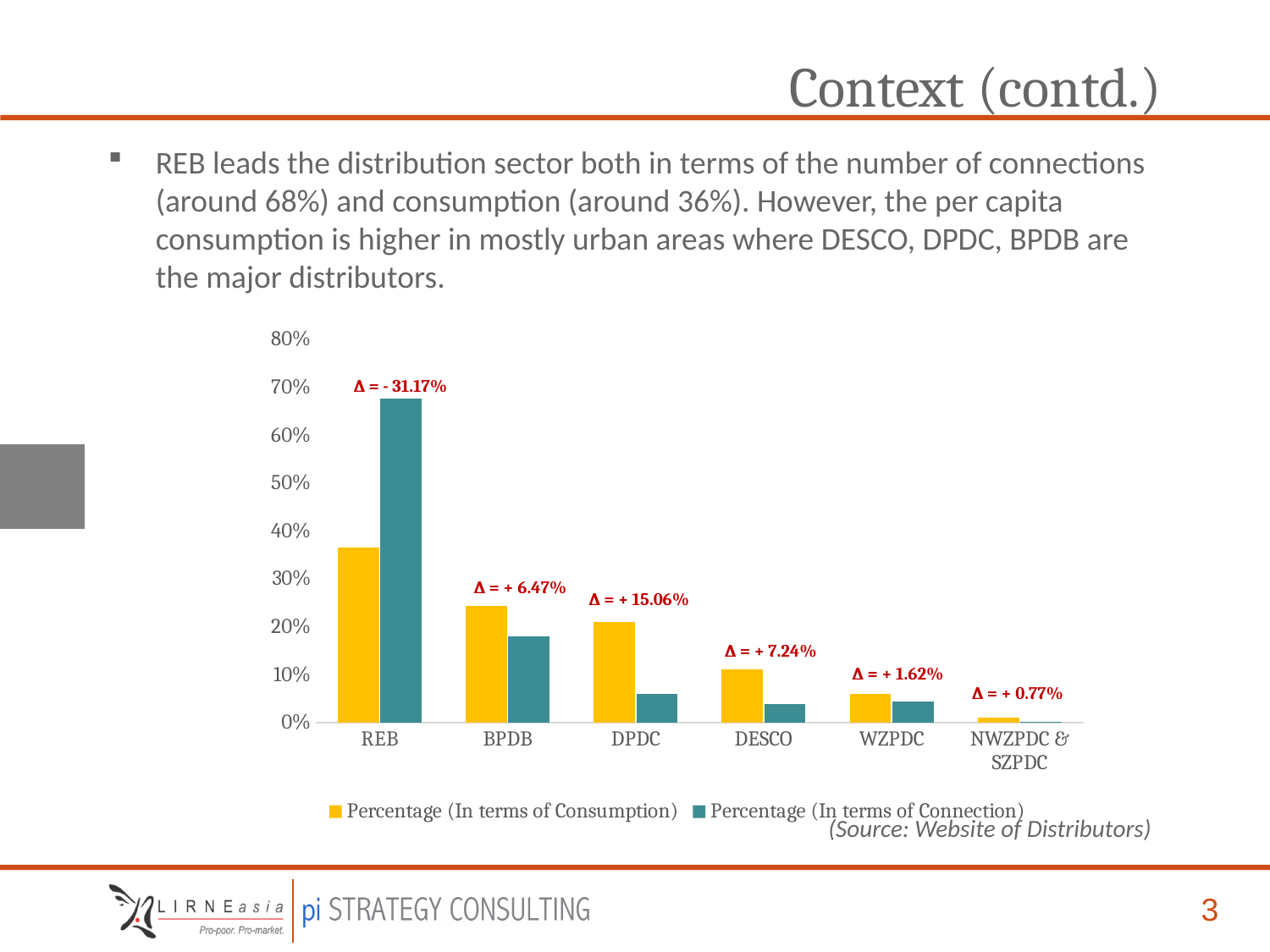
What is the Δ value annotated above the WZPDC bars? Δ = + 1.62% What kind of chart is shown on the slide? bar chart How many series does the chart legend list? 2 Is the value for REB in terms of Consumption greater or less than 40%? less Is the value for REB in terms of Connection greater or less than 60%? greater Which distributor has the highest value for Percentage (In terms of Connection)? REB What is the Δ value annotated above the DPDC bars? Δ = + 15.06% For BPDB, which is larger: Percentage (In terms of Consumption) or Percentage (In terms of Connection)? Percentage (In terms of Consumption) What is the Δ value annotated above the REB bars? Δ = - 31.17% Do the Percentage (In terms of Consumption) values rise or fall moving from REB to NWZPDC & SZPDC along the x axis? fall Which distributor has the lowest value for Percentage (In terms of Consumption)? NWZPDC & SZPDC How many distributor categories are shown on the x axis of the chart? 6